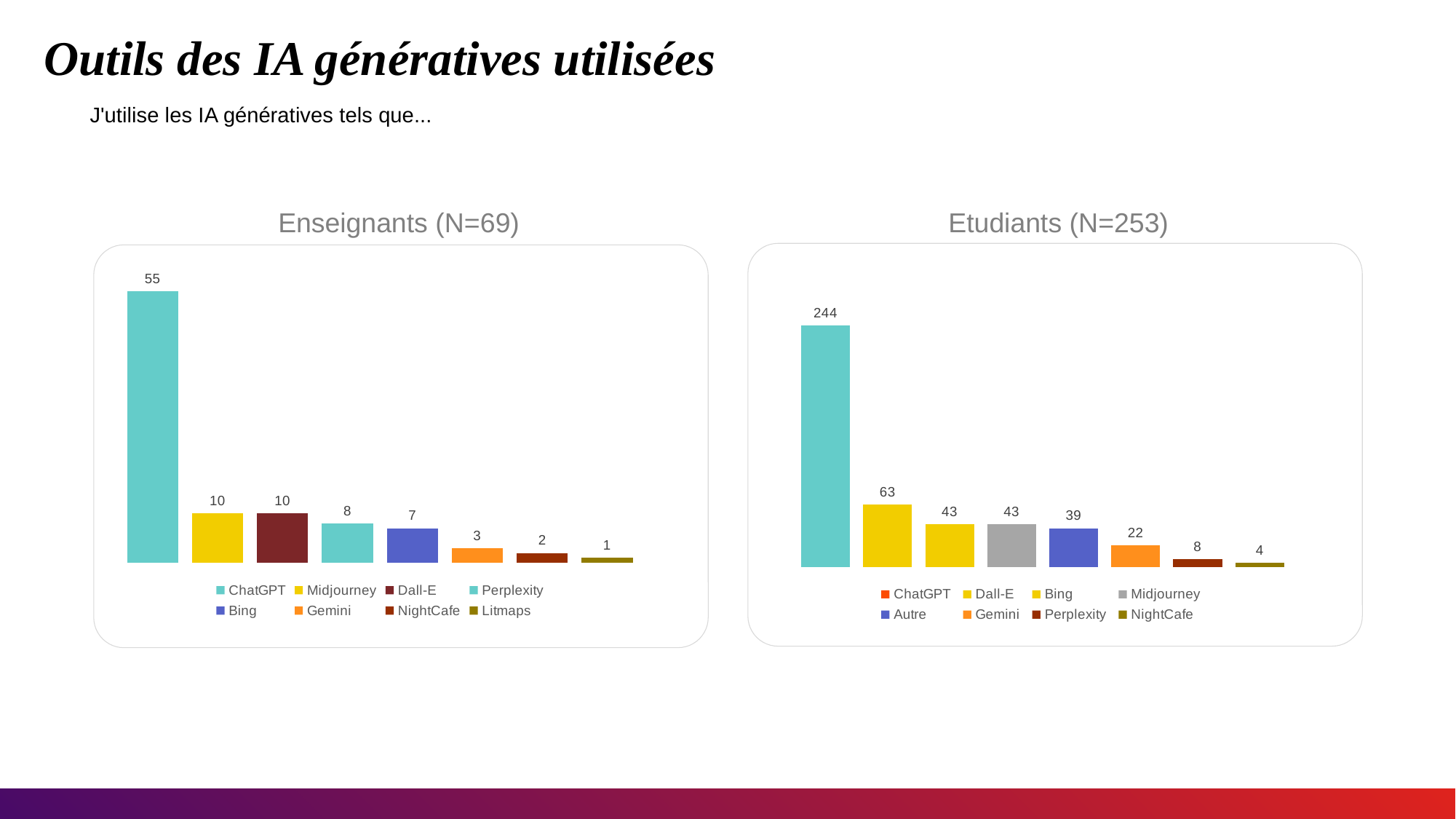
How many tools are shown in the Enseignants (N=69) chart? 8 In the Etudiants (N=253) chart, what is the value for ChatGPT? 244 In the Etudiants (N=253) chart, which tool has the highest value? ChatGPT What is the title of the chart on the left of the slide? Enseignants (N=69) What kind of chart is the Etudiants (N=253) chart? Bar chart In the Etudiants (N=253) chart, what is the difference between the values for ChatGPT and Dall-E? 181 In the Enseignants (N=69) chart, what is the value for Perplexity? 8 In the Enseignants (N=69) chart, what is the difference between the values for ChatGPT and Midjourney? 45 In the Enseignants (N=69) chart, which tool has the lowest value? Litmaps In the Enseignants (N=69) chart, what is the value for ChatGPT? 55 In the Etudiants (N=253) chart, which is larger, the value for Autre or the value for Gemini? Autre In the Etudiants (N=253) chart, what is the value for Dall-E? 63